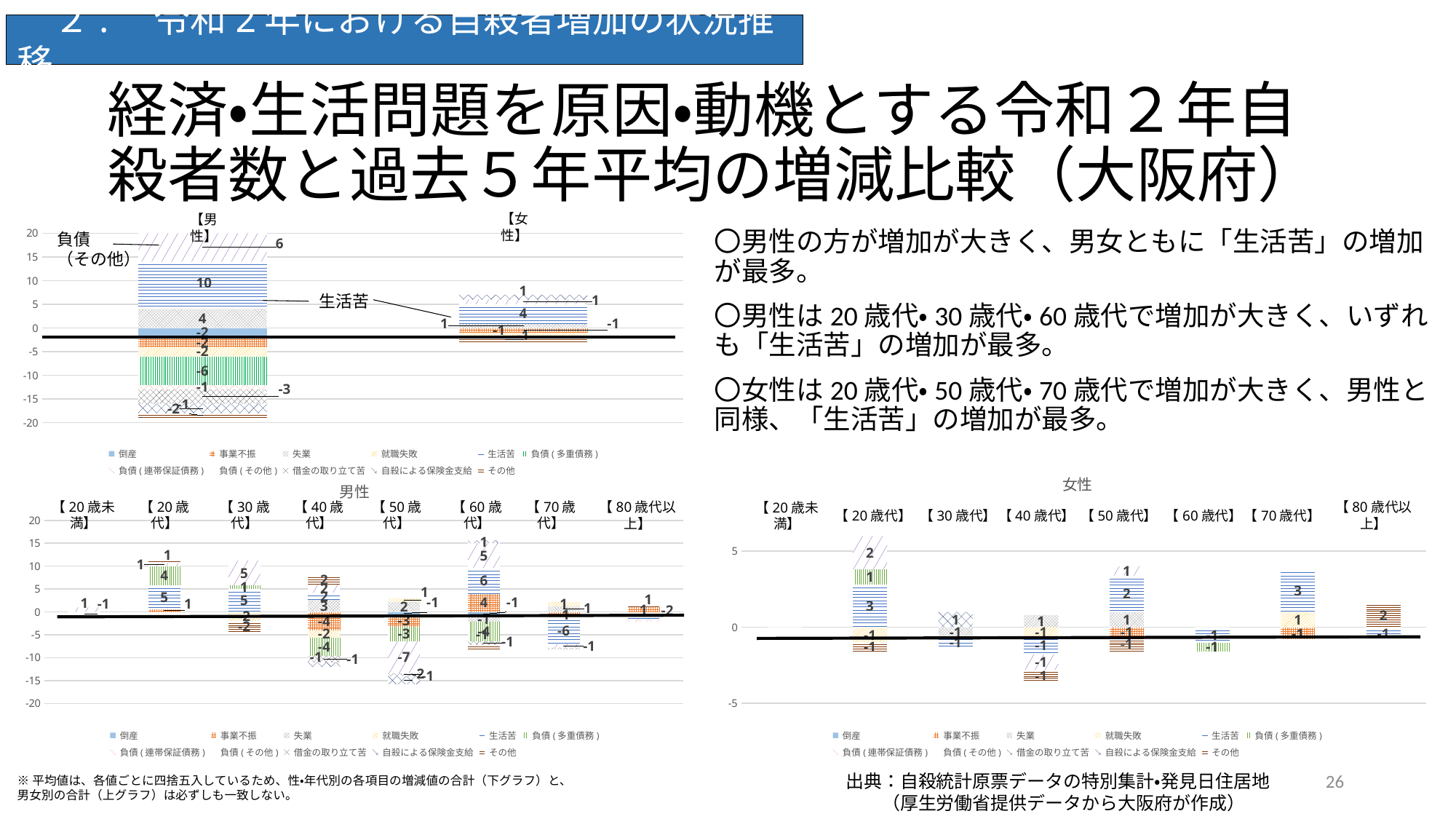
In the top-left chart, what is the value of 生活苦 for 女性? 4 How many age categories are shown in the bottom-left chart titled 男性? 8 In the bottom-left chart titled 男性, what is the 生活苦 value for 【60歳代】? 6 What is the highest value shown on the vertical axis of the bottom-right chart titled 女性? 5 In the top-left chart, what is the difference between the 生活苦 value for 男性 and for 女性? 6 In the top-left chart, what is the value of 負債（その他） for 男性? 6 In the top-left chart, which has the larger 生活苦 value, 男性 or 女性? 男性 How many series does the legend of the bottom-right chart titled 女性 list? 11 What kind of chart is the bottom-left chart titled 男性? bar chart In the top-left chart, what is the value of 生活苦 for 男性? 10 In the bottom-right chart titled 女性, what is the 生活苦 value for 【20歳代】? 3 In the top-left chart, what is the value of 負債（多重債務） for 男性? -6